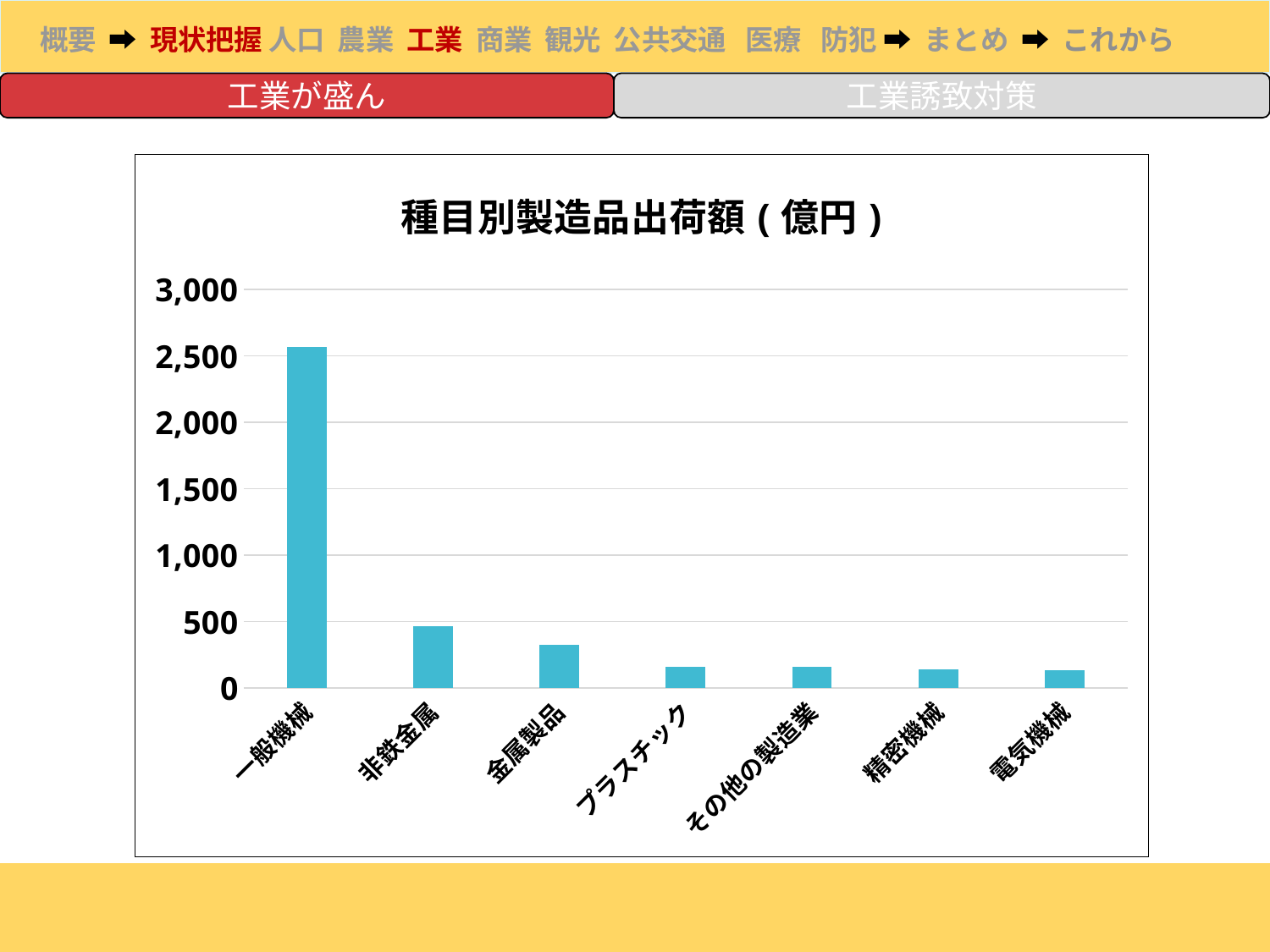
Which category has the highest value in the chart? 一般機械 Do the values generally rise or fall from left to right along the x axis? fall How many categories are plotted in the chart? 7 Is the value for 非鉄金属 greater or less than 500? less What is the highest value shown on the vertical axis? 3,000 Is the value for 一般機械 greater or less than 2,500? greater Which is larger, the value for 非鉄金属 or the value for 金属製品? 非鉄金属 What kind of chart is shown on the slide? bar chart What is the title of the chart? 種目別製造品出荷額（億円） Which is larger, the value for 一般機械 or the value for 非鉄金属? 一般機械 Is the value for 一般機械 greater or less than 3,000? less